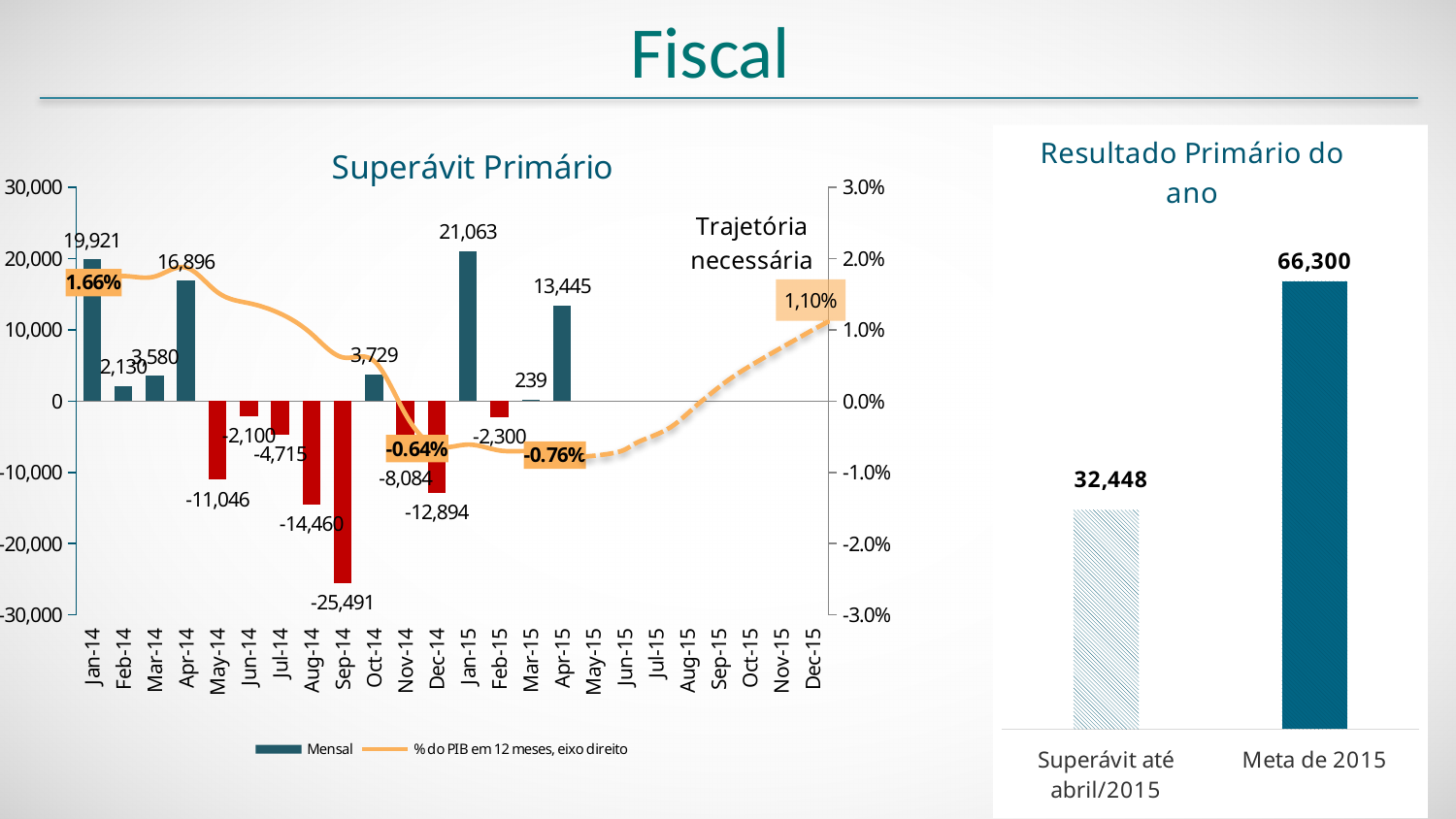
In the 'Superávit Primário' chart, which is larger, the Mensal value for Jan-14 or for Apr-14? Jan-14 In the 'Resultado Primário do ano' chart, what kind of chart is shown? bar chart In the 'Superávit Primário' chart, what is the Mensal value for Sep-14? -25,491 In the 'Resultado Primário do ano' chart, what is the value for Superávit até abril/2015? 32,448 In the 'Superávit Primário' chart, what is the difference between the Mensal values for Jan-15 and Apr-15? 7,618 In the 'Superávit Primário' chart, what is the '% do PIB em 12 meses' value labelled at Jan-14? 1.66% In the 'Superávit Primário' chart, which month has the highest Mensal value? Jan-15 In the 'Resultado Primário do ano' chart, what is the value for Meta de 2015? 66,300 In the 'Superávit Primário' chart, how many series does the legend list? 2 In the 'Superávit Primário' chart, which month has the lowest Mensal value? Sep-14 In the 'Resultado Primário do ano' chart, what is the difference between Meta de 2015 and Superávit até abril/2015? 33,852 In the 'Superávit Primário' chart, what is the Mensal value for Jan-15? 21,063